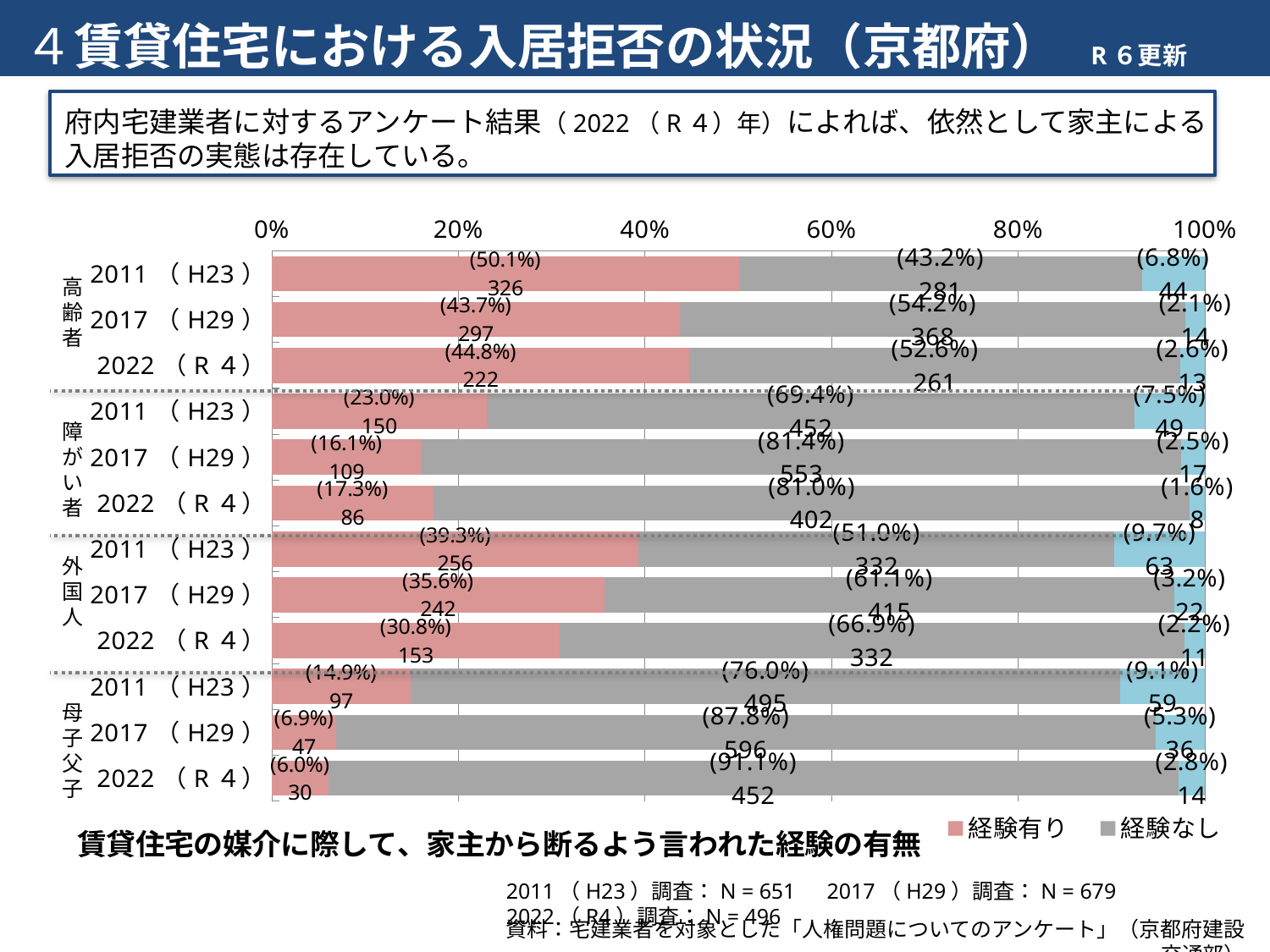
What is the 経験なし percentage for 母子父子 in 2022 (R4)? 91.1% Which is larger, the 経験有り percentage for 高齢者 2022 (R4) or for 障がい者 2022 (R4)? 高齢者 2022 (R4) Does the 経験有り percentage for 外国人 rise or fall from 2011 to 2022? Fall What is the 経験有り count for 障がい者 in 2022 (R4)? 86 How many bars (category rows) are plotted in the chart? 12 Which bar has the lowest 経験有り percentage? 母子父子 2022 (R4) What type of chart is shown on the slide? Stacked bar chart What is the 経験有り percentage for 高齢者 in 2011 (H23)? 50.1% Which bar has the highest 経験有り percentage? 高齢者 2011 (H23) Is the 経験有り share for 母子父子 2011 (H23) greater or less than 20%? less What is the difference in 経験有り percentage between 外国人 2011 (H23) and 外国人 2022 (R4)? 8.5 percentage points How many series does the legend list? 2